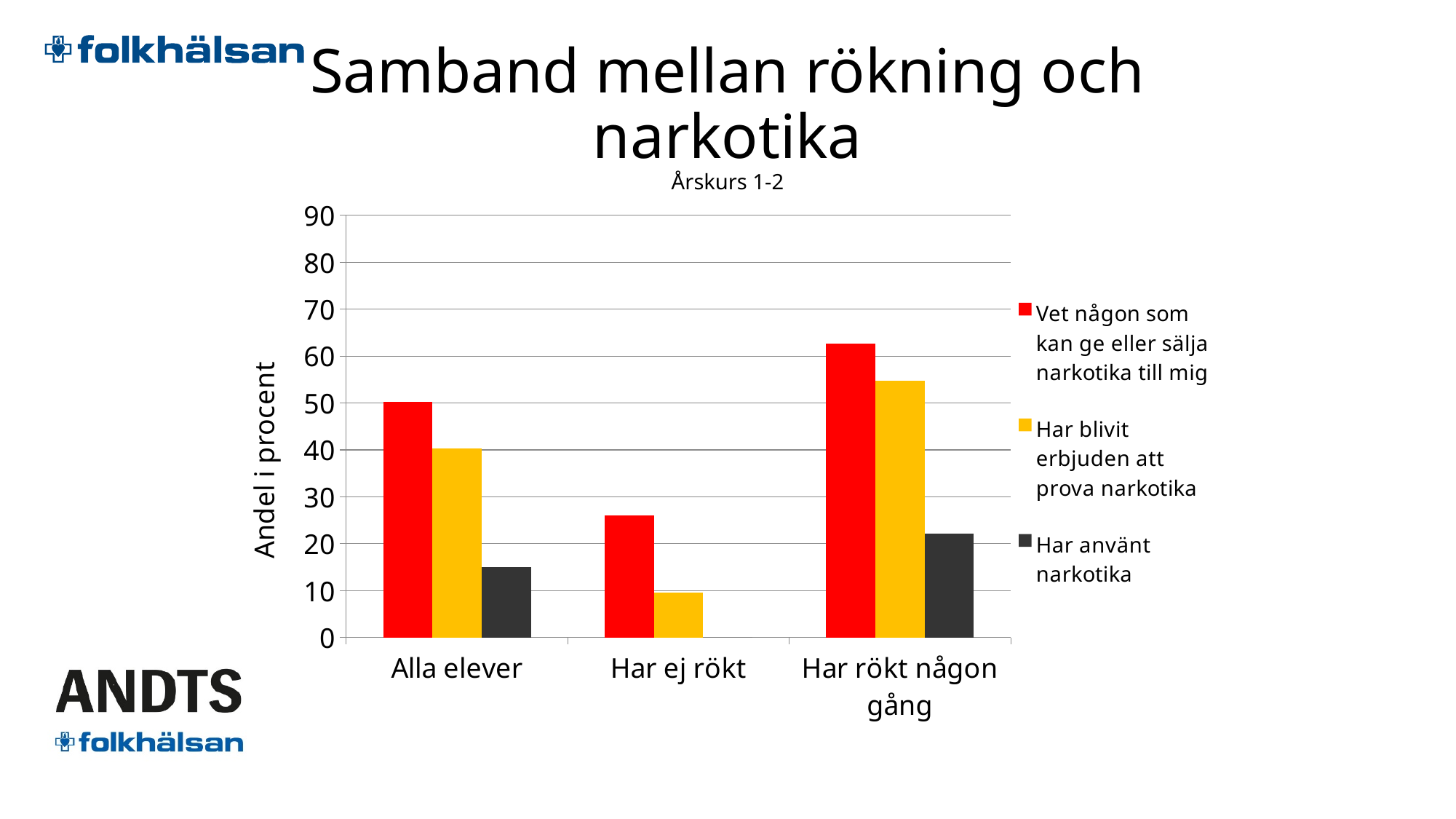
Is the value for 'Har blivit erbjuden att prova narkotika' in the 'Har rökt någon gång' category greater or less than 50? greater Which category has the highest value for 'Vet någon som kan ge eller sälja narkotika till mig'? Har rökt någon gång How many categories are shown on the x axis? 3 Which is larger in the 'Alla elever' category: 'Vet någon som kan ge eller sälja narkotika till mig' or 'Har blivit erbjuden att prova narkotika'? Vet någon som kan ge eller sälja narkotika till mig What kind of chart is shown on the slide? bar chart Which category has the lowest value for 'Har blivit erbjuden att prova narkotika'? Har ej rökt How many series does the legend list? 3 What is the subtitle shown above the chart? Årskurs 1-2 Is the value for 'Har blivit erbjuden att prova narkotika' in the 'Har ej rökt' category greater or less than 20? less What is the label of the y axis? Andel i procent Is the value for 'Vet någon som kan ge eller sälja narkotika till mig' in the 'Har rökt någon gång' category greater or less than 60? greater